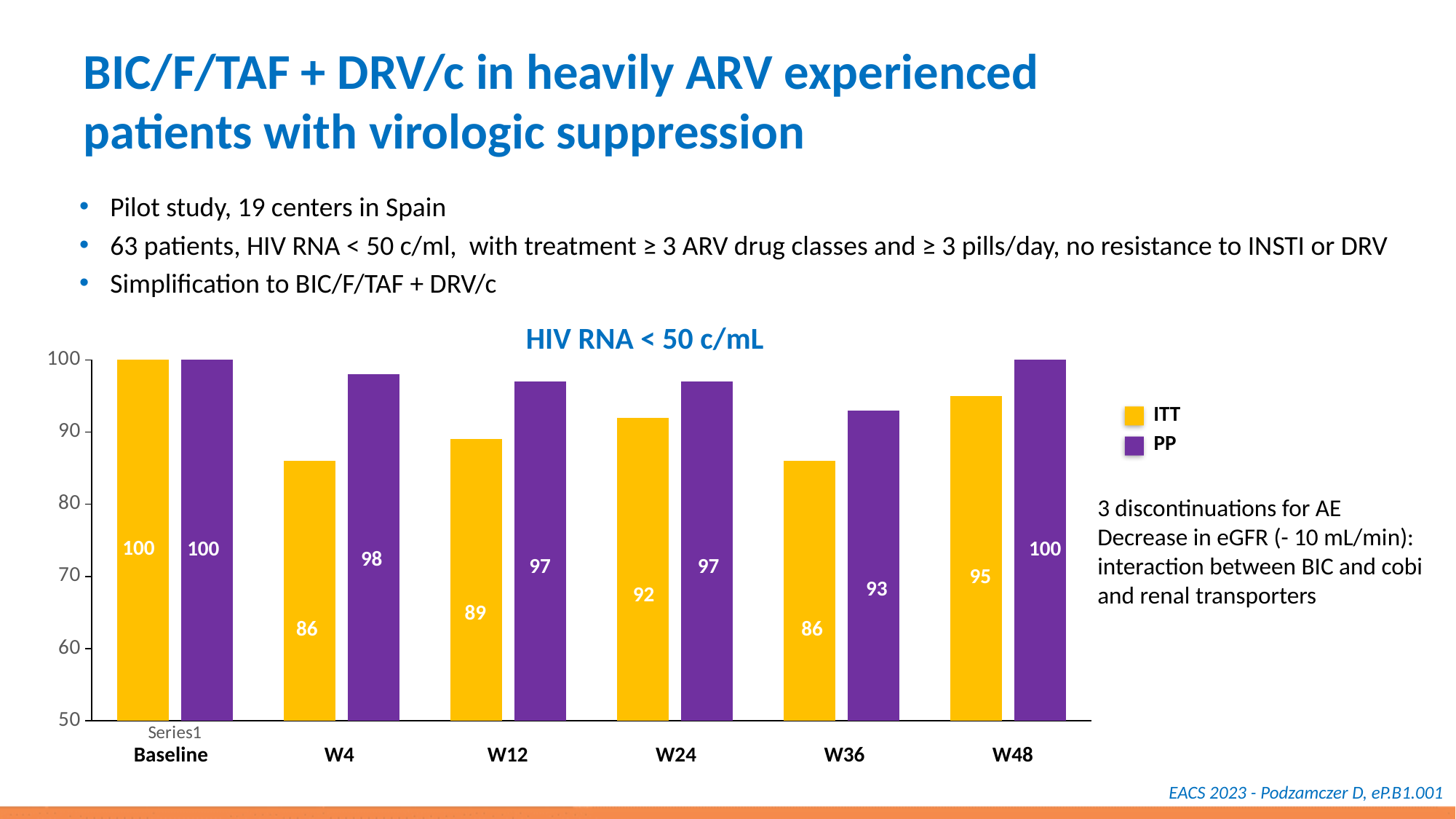
How many series does the legend list? 2 Which time point has the lowest PP value? W36 Which colour represents the PP series? purple What is the ITT value at W4? 86 What is the difference between the PP and ITT values at W12? 8 At W24, which series has the larger value, ITT or PP? PP What is the PP value at W36? 93 What is the ITT value at W48? 95 What kind of chart is shown on the slide? bar chart What is the title of the chart? HIV RNA < 50 c/mL How many time points are shown on the x axis? 6 Is the ITT value at W36 greater or less than 90? less